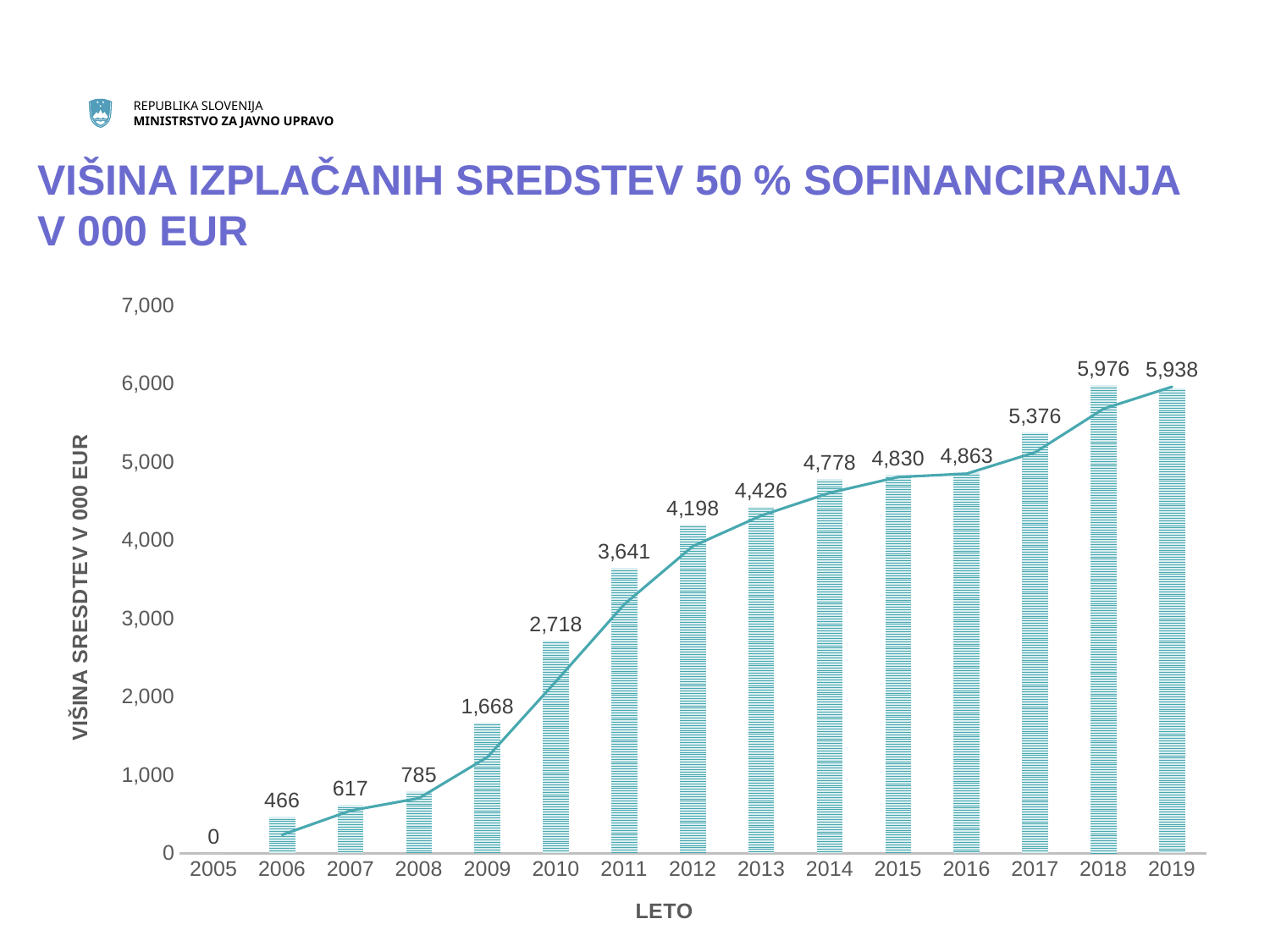
Which year has the highest value? 2018 Do the values generally rise or fall from 2005 to 2019? rise Which is larger, the value for 2013 or the value for 2012? 2013 What is the difference between the values for 2018 and 2019? 38 What is the value for 2006? 466 Is the value for 2012 greater or less than 4,000? greater What kind of chart is this? bar chart What is the value for 2017? 5,376 How many years are shown on the x axis? 15 What is the difference between the values for 2010 and 2009? 1,050 What is the value for 2010? 2,718 Which year has the lowest value? 2005